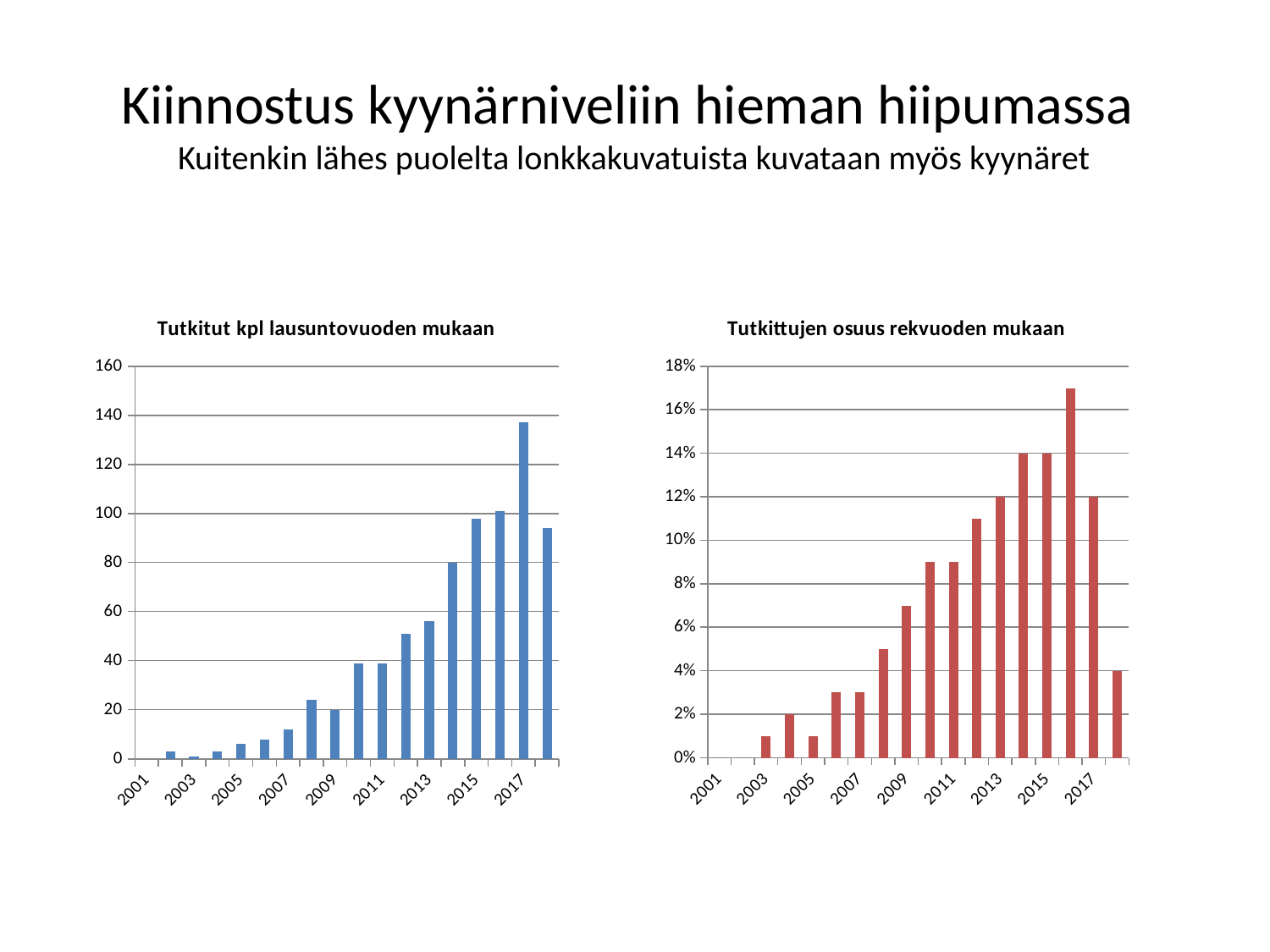
In the right chart 'Tutkittujen osuus rekvuoden mukaan', what is the value for 2018? 4% In the right chart 'Tutkittujen osuus rekvuoden mukaan', which year has the highest value? 2016 In the right chart 'Tutkittujen osuus rekvuoden mukaan', what is the value for 2014? 14% What is the title of the right chart? Tutkittujen osuus rekvuoden mukaan In the right chart 'Tutkittujen osuus rekvuoden mukaan', is the value for 2016 greater or less than 16%? greater In the left chart 'Tutkitut kpl lausuntovuoden mukaan', which year has the highest value? 2017 In the left chart 'Tutkitut kpl lausuntovuoden mukaan', is the value for 2013 greater or less than 60? less In the left chart 'Tutkitut kpl lausuntovuoden mukaan', is the value for 2018 greater or less than 100? less In the left chart 'Tutkitut kpl lausuntovuoden mukaan', which is larger, the value for 2017 or the value for 2018? 2017 What type of chart is the left chart titled 'Tutkitut kpl lausuntovuoden mukaan'? bar chart In the right chart 'Tutkittujen osuus rekvuoden mukaan', which is larger, the value for 2016 or the value for 2017? 2016